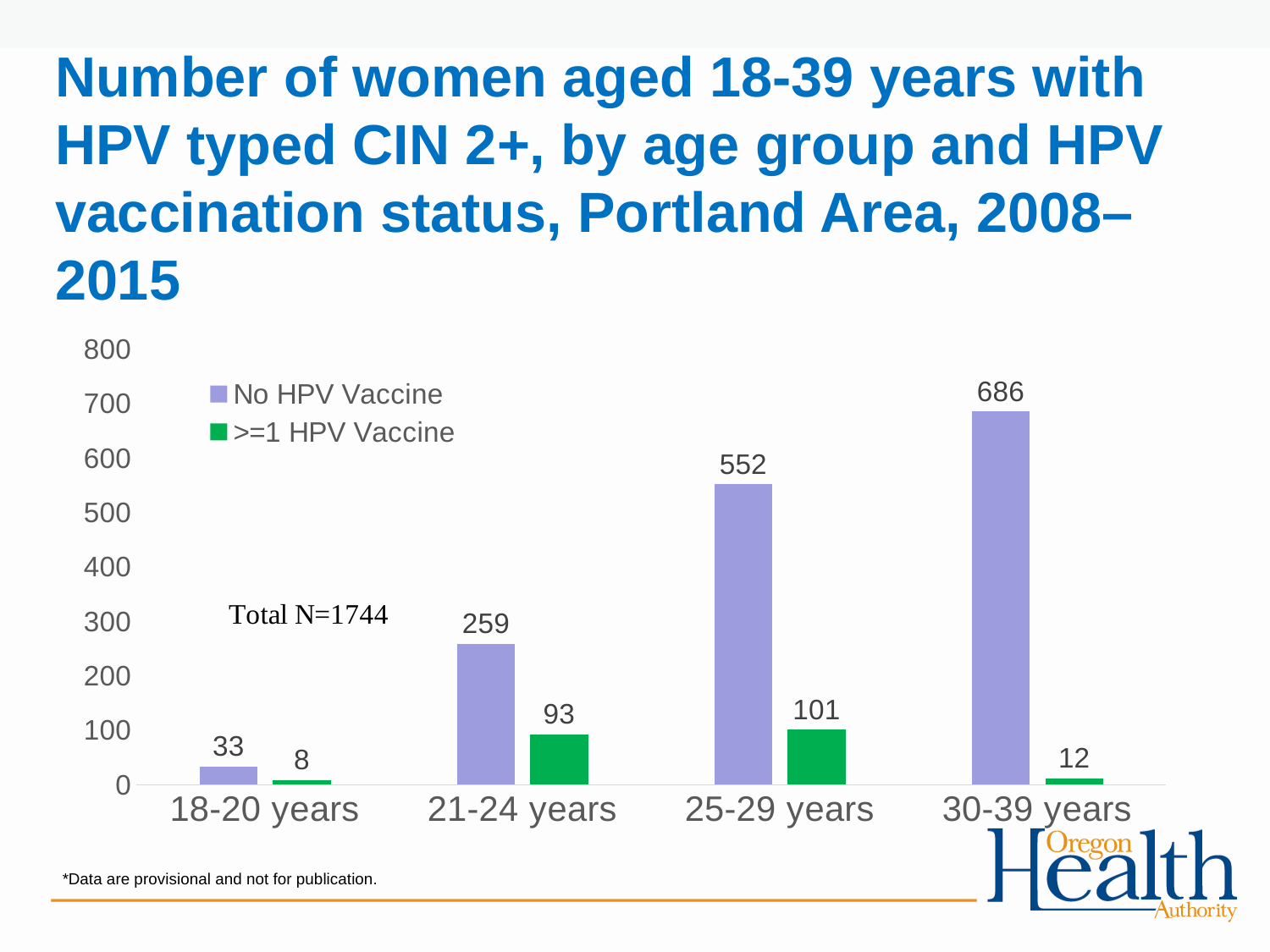
Which is larger: >=1 HPV Vaccine for 25-29 years or >=1 HPV Vaccine for 21-24 years? >=1 HPV Vaccine for 25-29 years What is the value for No HPV Vaccine in the 30-39 years age group? 686 Do the No HPV Vaccine values rise or fall as age group increases along the x axis? Rise Which age group has the highest value for No HPV Vaccine? 30-39 years What is the value for >=1 HPV Vaccine in the 21-24 years age group? 93 What is the difference between No HPV Vaccine and >=1 HPV Vaccine in the 25-29 years age group? 451 Which age group has the lowest value for >=1 HPV Vaccine? 18-20 years What total N is stated on the chart? Total N=1744 What kind of chart is shown on the slide? Bar chart What is the value for No HPV Vaccine in the 18-20 years age group? 33 How many age groups are shown on the x axis? 4 How many series does the legend list? 2